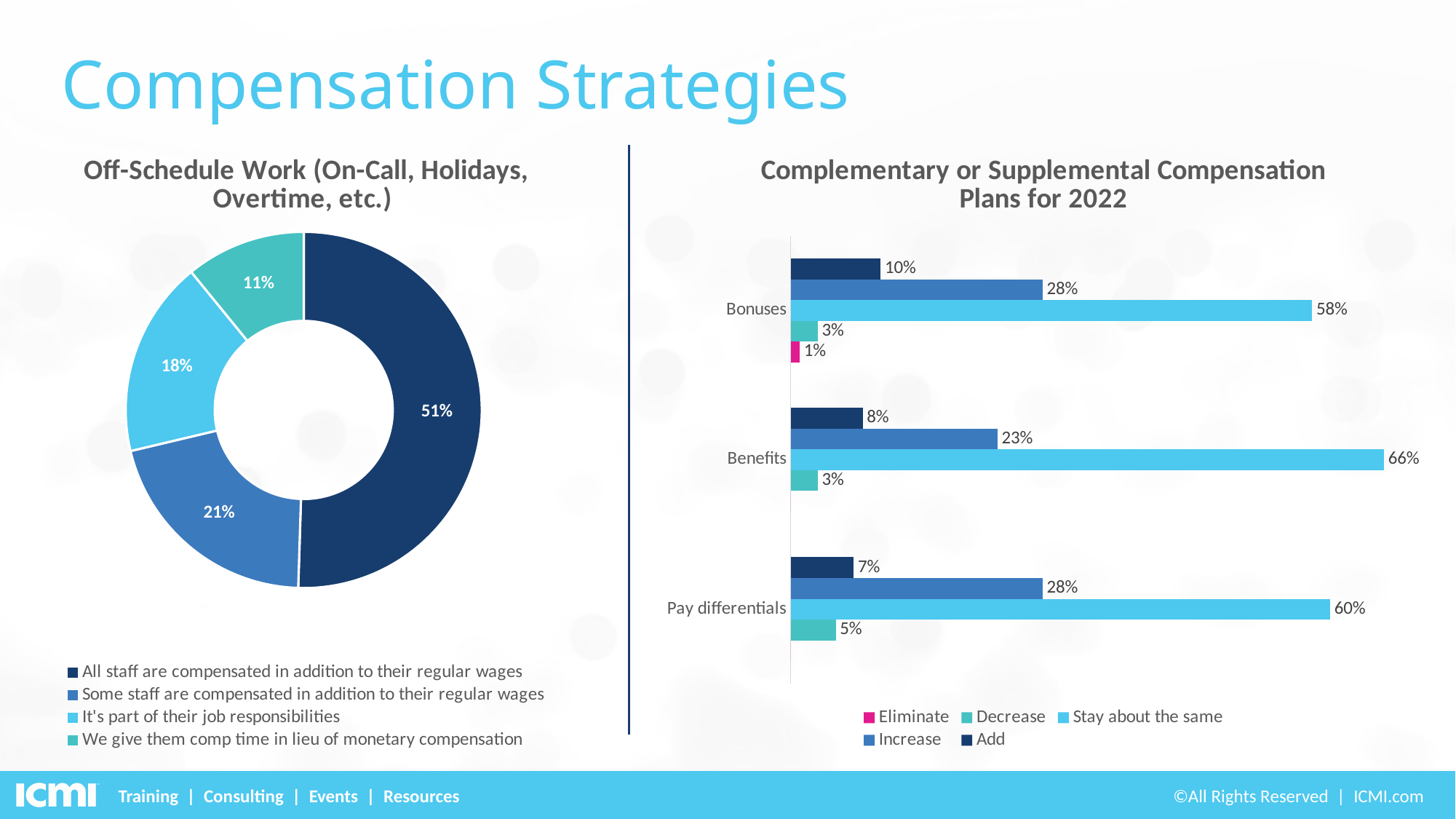
In the 'Off-Schedule Work' chart, which category has the smallest share? We give them comp time in lieu of monetary compensation In the 'Off-Schedule Work' chart, what share is 'All staff are compensated in addition to their regular wages'? 51% What kind of chart is the 'Complementary or Supplemental Compensation Plans for 2022' chart? Bar chart In the 'Complementary or Supplemental Compensation Plans for 2022' chart, is the 'Add' value larger for Bonuses or for Benefits? Bonuses What kind of chart is the 'Off-Schedule Work' chart? Doughnut chart How many series does the legend of the 'Complementary or Supplemental Compensation Plans for 2022' chart list? 5 In the 'Off-Schedule Work' chart, what share is 'We give them comp time in lieu of monetary compensation'? 11% In the 'Complementary or Supplemental Compensation Plans for 2022' chart, which category has the highest 'Stay about the same' value? Benefits In the 'Complementary or Supplemental Compensation Plans for 2022' chart, what is the 'Stay about the same' value for Benefits? 66% In the 'Off-Schedule Work' chart, what is the difference between 'Some staff are compensated in addition to their regular wages' and 'It's part of their job responsibilities'? 3% In the 'Complementary or Supplemental Compensation Plans for 2022' chart, what is the 'Eliminate' value for Bonuses? 1% In the 'Complementary or Supplemental Compensation Plans for 2022' chart, what is the 'Increase' value for Pay differentials? 28%